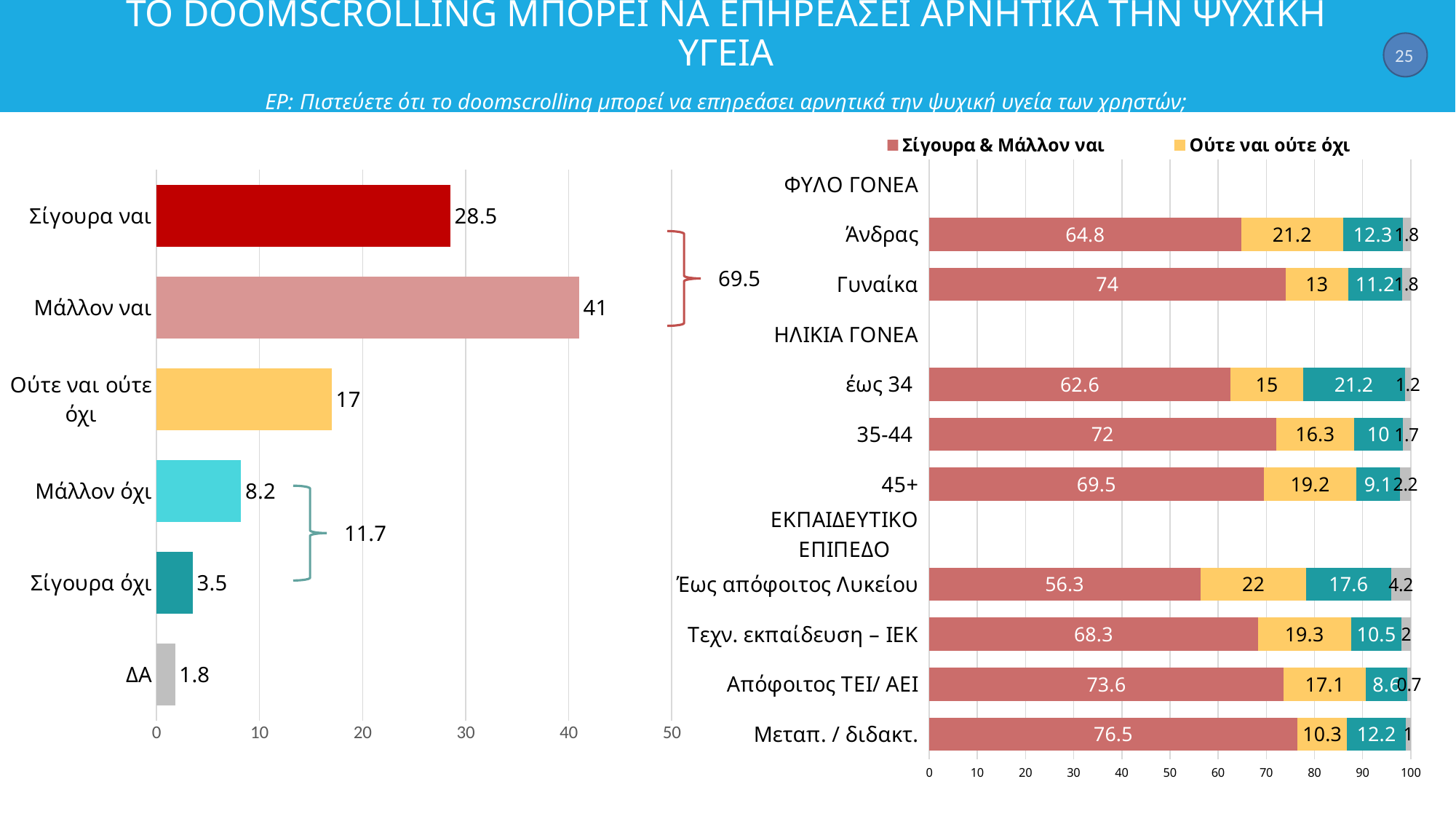
In the right stacked bar chart, what is the value of the "Σίγουρα & Μάλλον ναι" segment for "Γυναίκα"? 74 In the right stacked bar chart, what is the value of the "Ούτε ναι ούτε όχι" segment for "Έως απόφοιτος Λυκείου"? 22 In the left bar chart, which category has the lowest value? ΔΑ In the left bar chart, what is the value for "Μάλλον ναι"? 41 What kind of chart is the chart on the right side of the slide? Stacked bar chart In the left bar chart, which category has the highest value? Μάλλον ναι In the left bar chart, what combined value is shown by the bracket grouping "Μάλλον όχι" and "Σίγουρα όχι"? 11.7 In the left bar chart, what is the difference between the values for "Σίγουρα ναι" and "Ούτε ναι ούτε όχι"? 11.5 In the right stacked bar chart, which category has the highest "Σίγουρα & Μάλλον ναι" value? Μεταπ. / διδακτ. In the right stacked bar chart, is the "Σίγουρα & Μάλλον ναι" value larger for "Άνδρας" or for "Γυναίκα"? Γυναίκα In the left bar chart, how many categories are shown? 6 In the right stacked bar chart, what is the difference between the "Σίγουρα & Μάλλον ναι" values for "35-44" and "έως 34"? 9.4